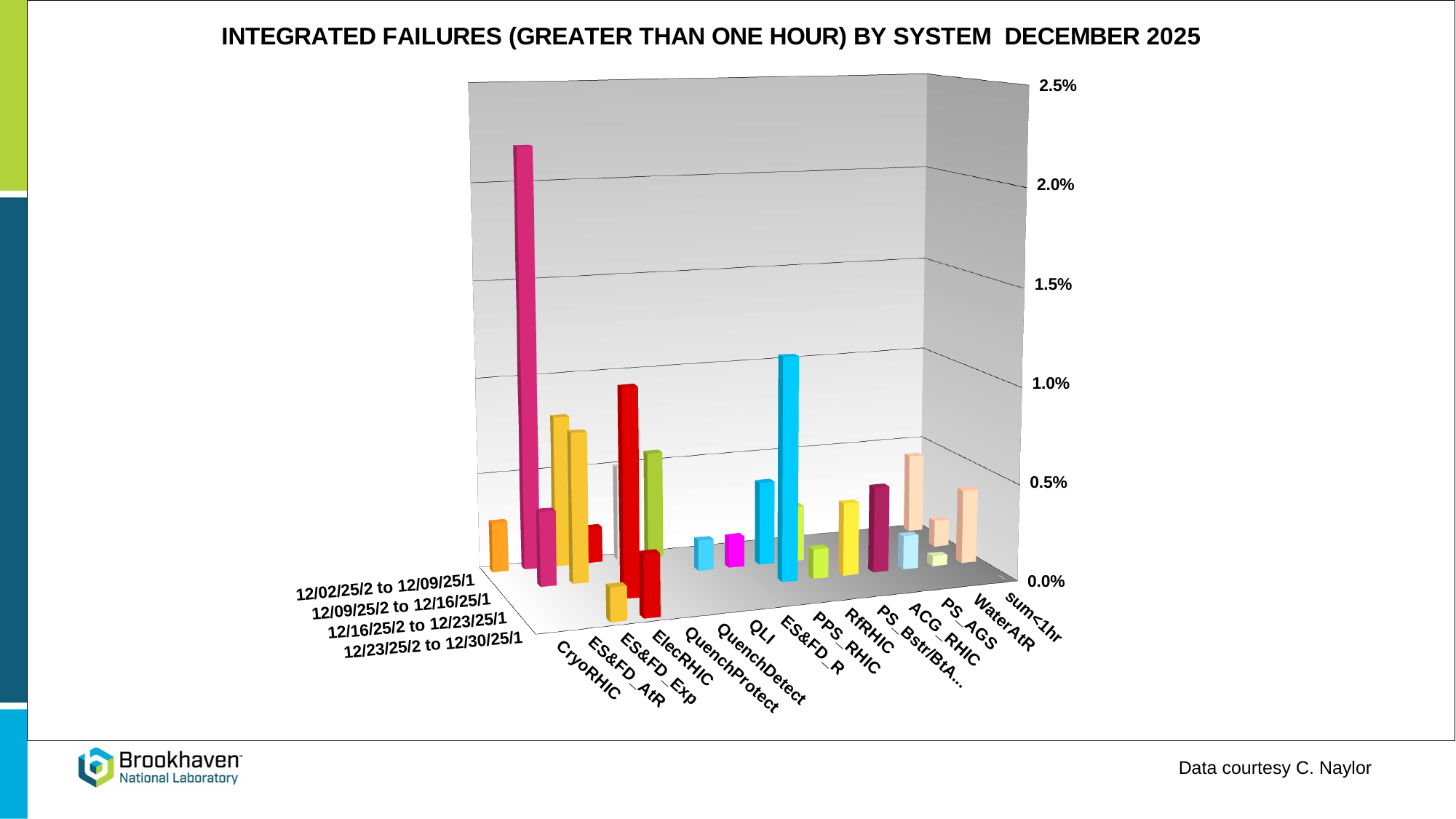
Is the tallest bar in the chart greater or less than 2.5%? less What is the title of the chart? INTEGRATED FAILURES (GREATER THAN ONE HOUR) BY SYSTEM DECEMBER 2025 How many system categories are listed along the x axis of the chart? 15 Which time period is listed first (at the back) on the depth axis? 12/02/25/2 to 12/09/25/1 Which time period is listed last (at the front) on the depth axis? 12/23/25/2 to 12/30/25/1 How many weekly time periods (series) are shown along the depth axis of the chart? 4 Is the tallest bar in the chart greater or less than 2.0%? greater What kind of chart is shown on the slide? bar chart How many percentage tick labels are shown on the vertical axis? 6 What is the highest value labelled on the vertical axis of the chart? 2.5%